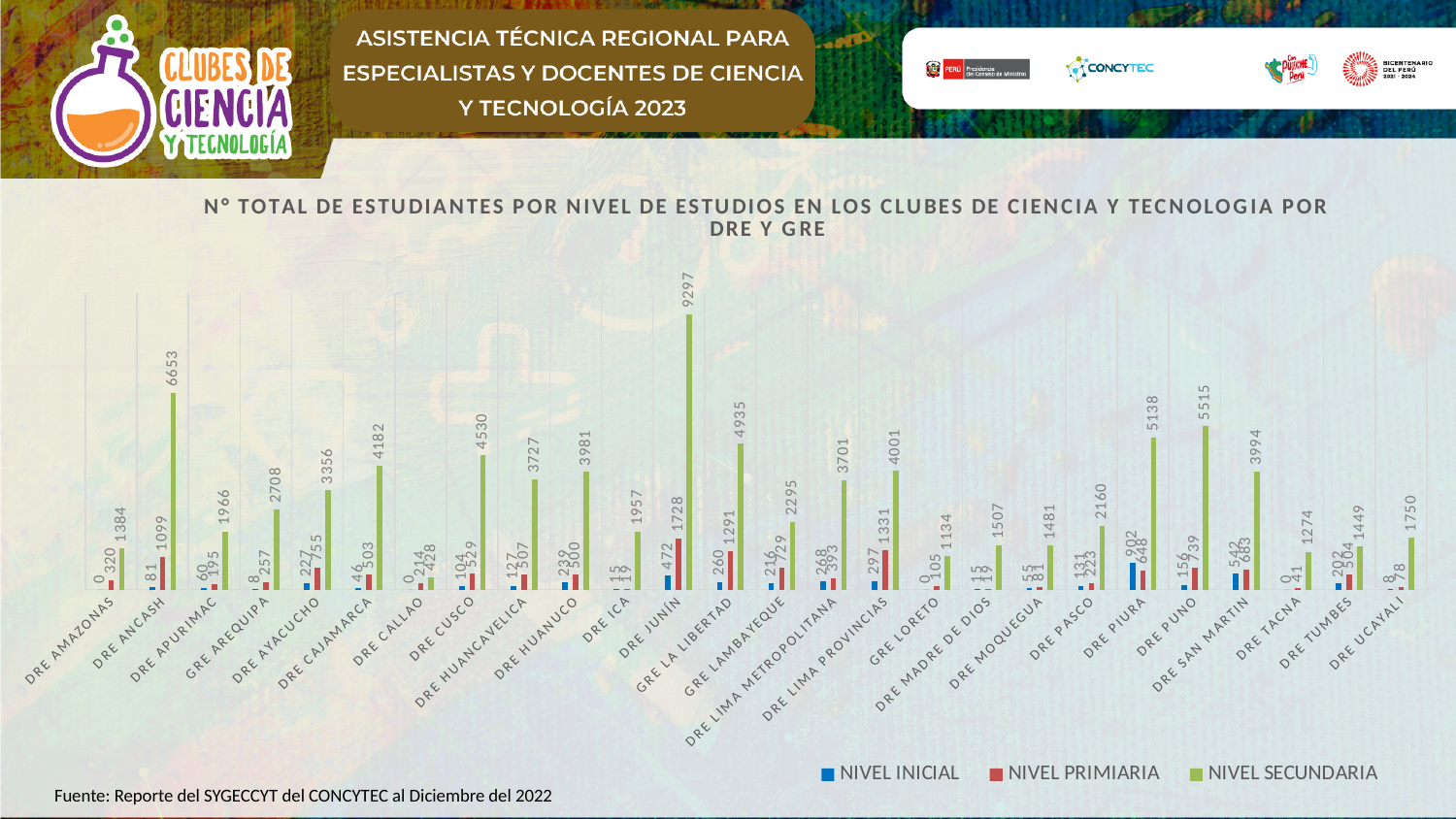
What is the NIVEL SECUNDARIA value for DRE JUNÍN? 9297 What is the total number of students across all three levels for DRE JUNÍN? 11497 What is the NIVEL INICIAL value for DRE SAN MARTIN? 542 Which category has the lowest NIVEL SECUNDARIA value? DRE CALLAO Which category has the highest NIVEL SECUNDARIA value? DRE JUNÍN How many DRE/GRE categories are shown on the x axis? 26 Which colour represents NIVEL PRIMARIA in the legend? Red Which has a larger NIVEL SECUNDARIA value, DRE PUNO or DRE PIURA? DRE PUNO What type of chart is shown on the slide? Bar chart What is the difference between the NIVEL SECUNDARIA values for DRE JUNÍN and DRE ANCASH? 2644 What is the NIVEL PRIMARIA value for DRE ANCASH? 1099 How many series does the legend list? 3